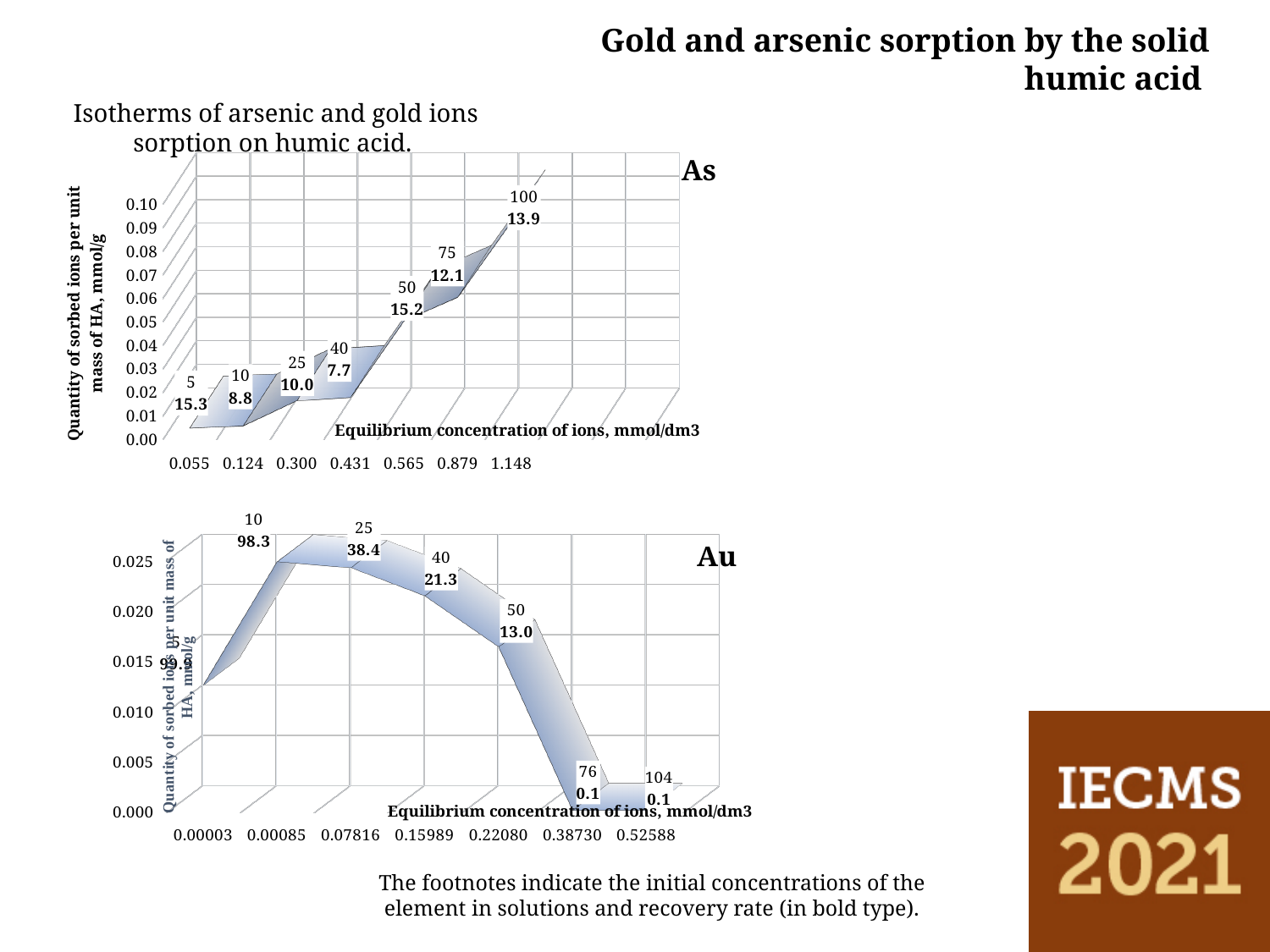
In the top chart labelled "As", is the quantity of sorbed ions at equilibrium concentration 1.148 greater or less than 0.05? greater In the top chart labelled "As", what initial concentration label is shown at the last point (equilibrium concentration 1.148)? 100 How many data points are plotted in the top chart labelled "As"? 7 What is the x-axis title of the bottom chart labelled "Au"? Equilibrium concentration of ions, mmol/dm3 In the bottom chart labelled "Au", what recovery rate (bold label) is shown at the point with initial concentration 25? 38.4 In the bottom chart labelled "Au", what recovery rate (bold label) is shown at the point with initial concentration 104? 0.1 In the top chart labelled "As", at which equilibrium concentration is the quantity of sorbed ions highest? 1.148 In the bottom chart labelled "Au", is the quantity of sorbed ions at equilibrium concentration 0.52588 greater or less than 0.005? less In the top chart labelled "As", what recovery rate (bold label) is shown at the point with initial concentration 50? 15.2 How many data points are plotted in the bottom chart labelled "Au"? 7 What kind of chart is the top chart labelled "As"? line chart In the bottom chart labelled "Au", does the quantity of sorbed ions rise or fall between equilibrium concentrations 0.22080 and 0.38730? fall